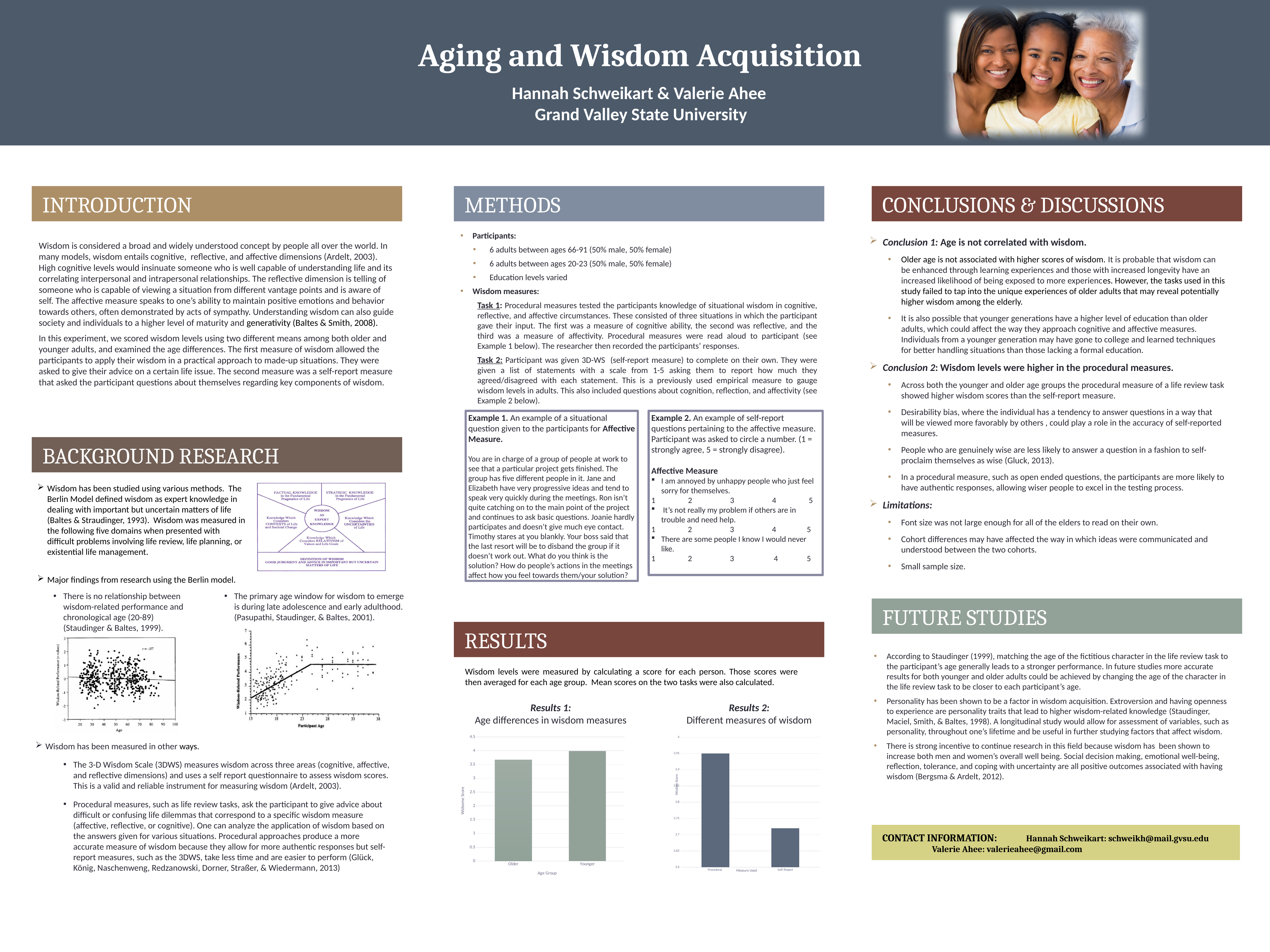
How many age groups are plotted in the 'Results 1: Age differences in wisdom measures' chart? 2 How many measures are plotted in the 'Results 2: Different measures of wisdom' chart? 2 In the 'Results 1: Age differences in wisdom measures' chart, is the wisdom score for Older greater or less than 3.5? greater In the 'Results 1: Age differences in wisdom measures' chart, which age group has the higher wisdom score? Younger In the 'Results 1: Age differences in wisdom measures' chart, is the wisdom score for Older greater or less than 4? less What kind of chart is 'Results 1: Age differences in wisdom measures'? bar chart In the 'Results 2: Different measures of wisdom' chart, which measure has the higher wisdom score? Procedural What is the x-axis label of the 'Results 1: Age differences in wisdom measures' chart? Age Group In the 'Results 2: Different measures of wisdom' chart, which measure has the lower wisdom score? Self-Report In the 'Results 2: Different measures of wisdom' chart, is the wisdom score for Procedural greater or less than 3.9? greater In the 'Results 1: Age differences in wisdom measures' chart, which age group has the lower wisdom score? Older